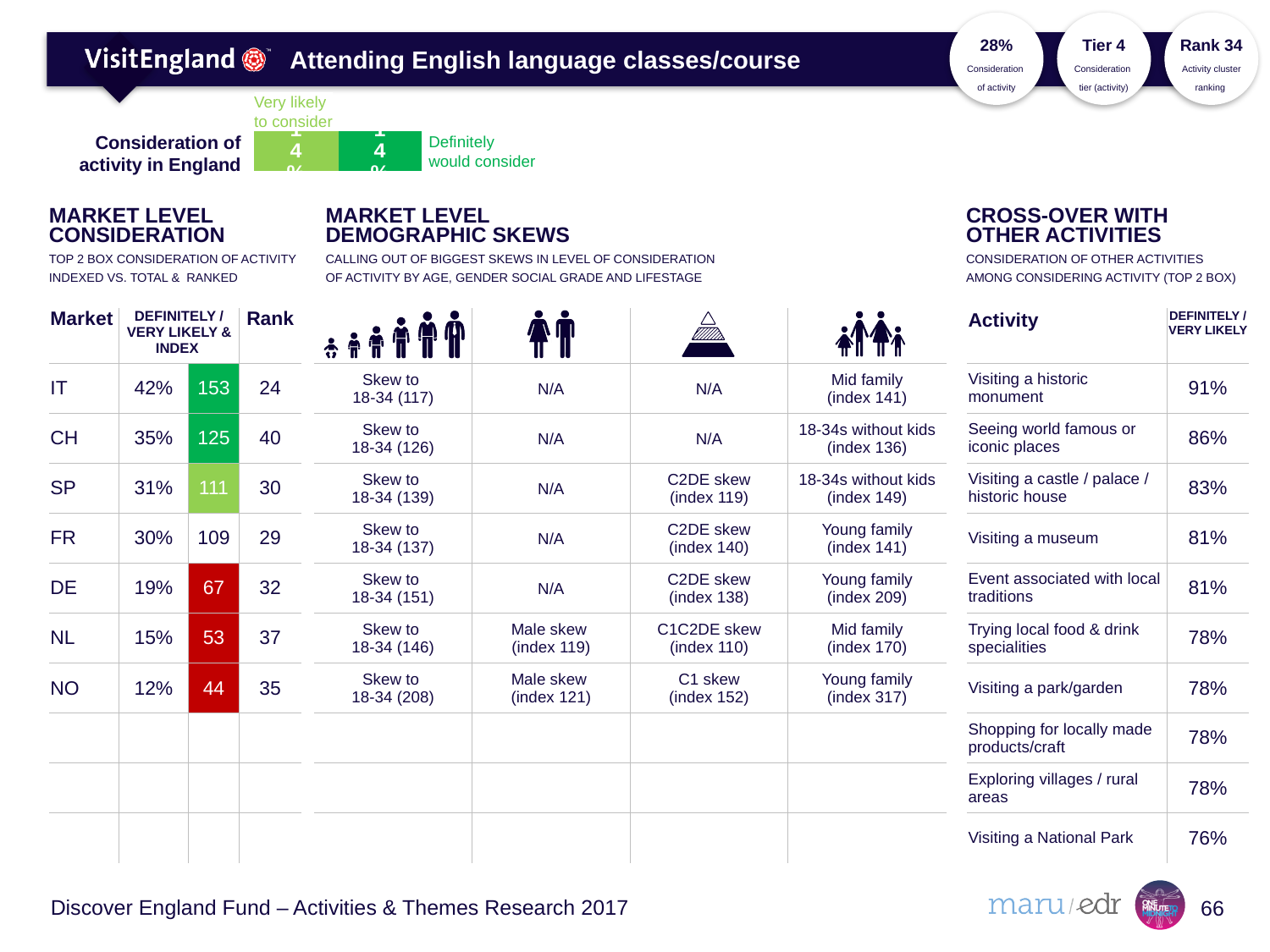
Is the value for 'Definitely would consider' in the 'Consideration of activity in England' chart greater or less than 20%? less How many series does the 'Consideration of activity in England' chart show? 2 In the 'Consideration of activity in England' chart, what is the value for 'Definitely would consider'? 14% In the 'Consideration of activity in England' chart, what is the value for 'Very likely to consider'? 14% What type of chart is the 'Consideration of activity in England' chart? bar chart What is the total of the stacked bar in the 'Consideration of activity in England' chart? 28% In the 'Consideration of activity in England' chart, what is the difference between 'Very likely to consider' and 'Definitely would consider'? 0% In the 'Consideration of activity in England' chart, which segment is shown in the lighter green colour? Very likely to consider